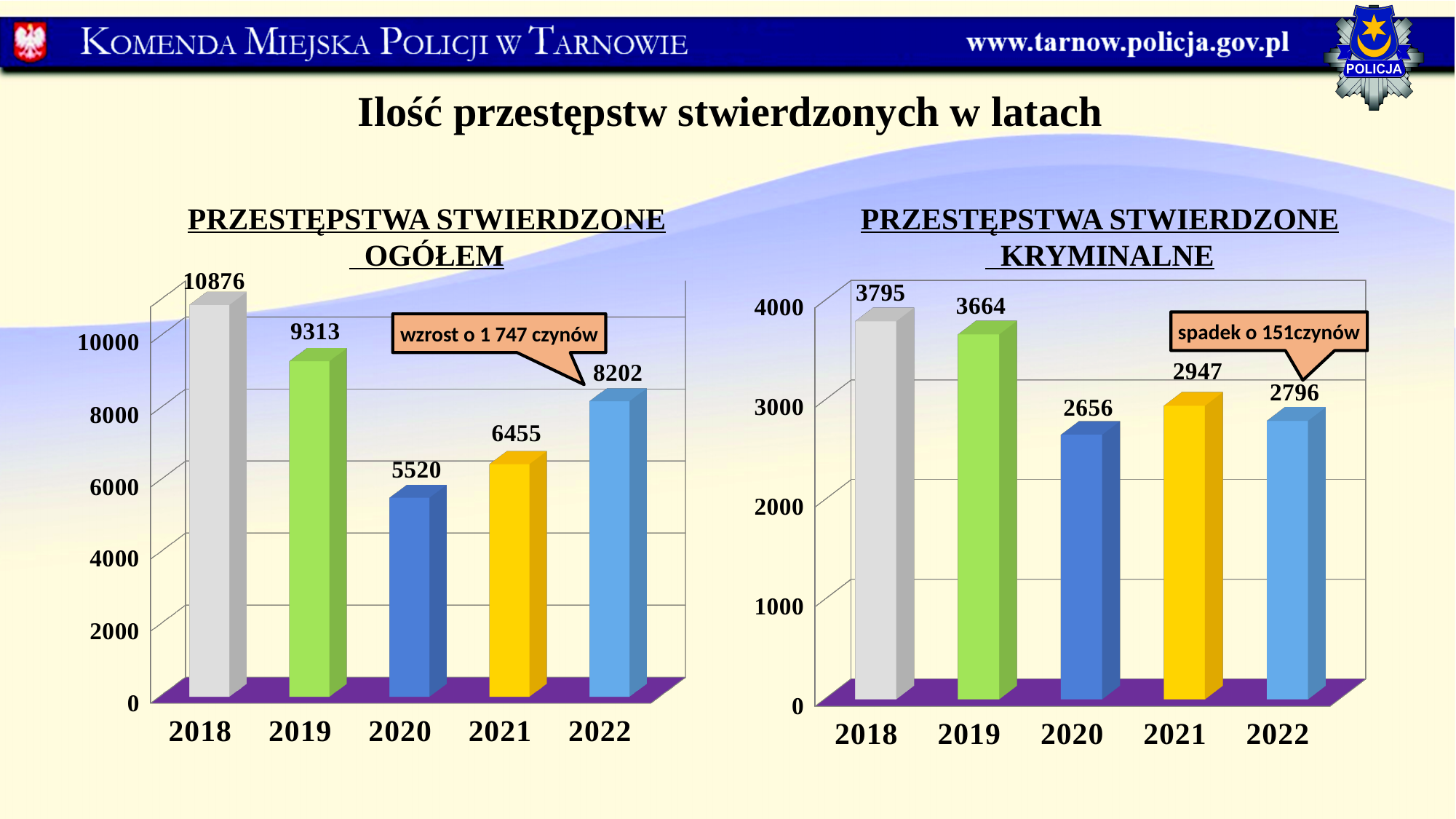
In the chart titled PRZESTĘPSTWA STWIERDZONE OGÓŁEM, what is the value for 2021? 6455 How many years are shown in the chart titled PRZESTĘPSTWA STWIERDZONE OGÓŁEM? 5 In the chart titled PRZESTĘPSTWA STWIERDZONE KRYMINALNE, what is the difference between the values for 2021 and 2022? 151 In the chart titled PRZESTĘPSTWA STWIERDZONE KRYMINALNE, what is the value for 2022? 2796 In the chart titled PRZESTĘPSTWA STWIERDZONE OGÓŁEM, do the values rise or fall from 2018 to 2020? fall What kind of chart is the chart titled PRZESTĘPSTWA STWIERDZONE KRYMINALNE? bar chart In the chart titled PRZESTĘPSTWA STWIERDZONE OGÓŁEM, what is the difference between the values for 2022 and 2021? 1747 In the chart titled PRZESTĘPSTWA STWIERDZONE KRYMINALNE, which year has the highest value? 2018 In the chart titled PRZESTĘPSTWA STWIERDZONE KRYMINALNE, what is the value for 2020? 2656 In the chart titled PRZESTĘPSTWA STWIERDZONE OGÓŁEM, what is the value for 2018? 10876 In the chart titled PRZESTĘPSTWA STWIERDZONE KRYMINALNE, which is larger, the value for 2019 or the value for 2021? 2019 In the chart titled PRZESTĘPSTWA STWIERDZONE OGÓŁEM, which year has the lowest value? 2020